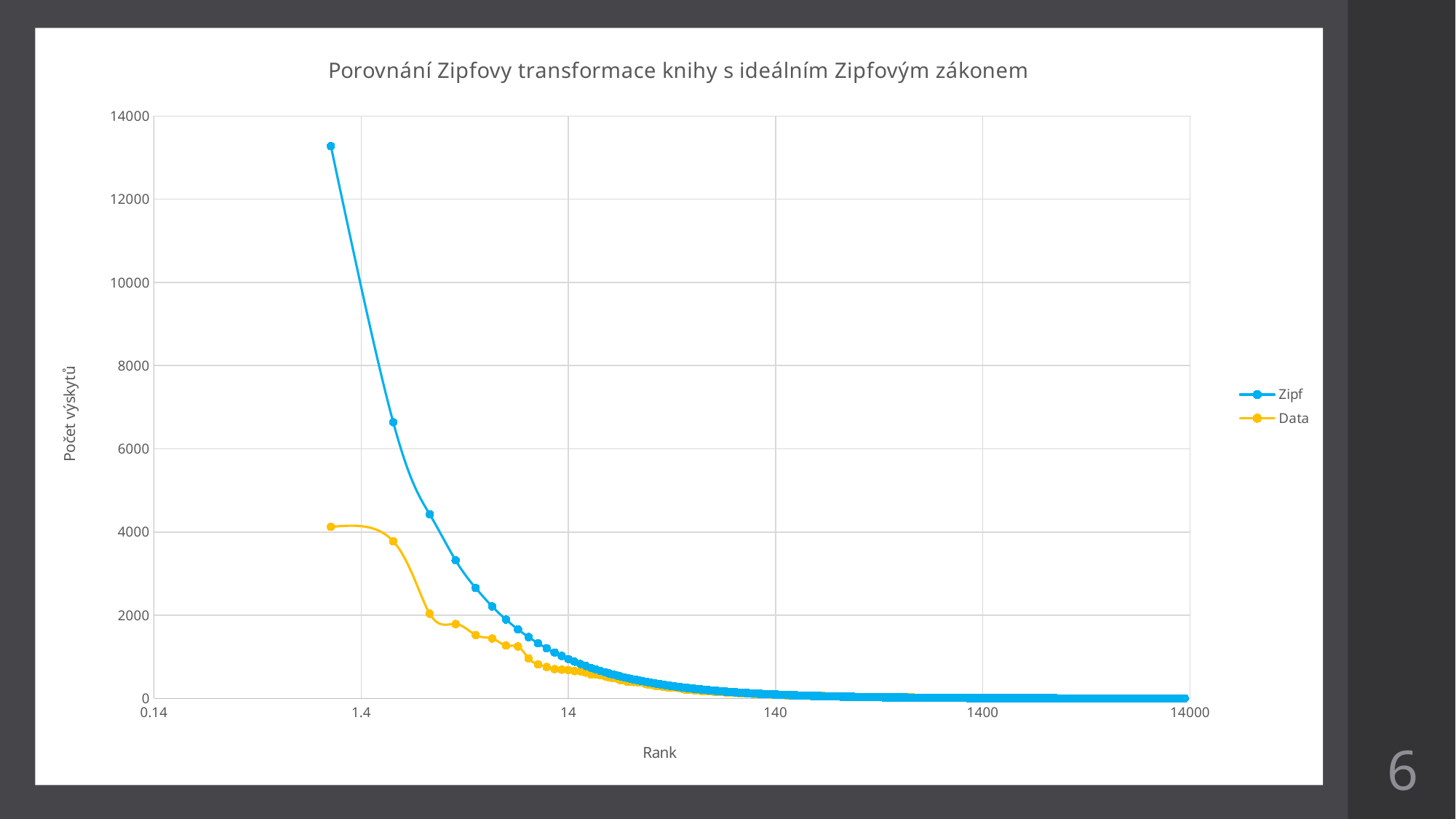
What is the largest value shown on the y axis? 14000 How many series does the legend list? 2 What is the label of the x axis? Rank Do the values of the Zipf series rise or fall as rank increases along the x axis? fall At the lowest rank, which series has the larger value, Zipf or Data? Zipf Which series reaches the highest value on the chart? Zipf Is the highest value of the Data series greater or less than 6000? less Is the highest value of the Data series greater or less than 2000? greater Which series is drawn in blue? Zipf What kind of chart is shown on the slide? line chart What is the title of the chart? Porovnání Zipfovy transformace knihy s ideálním Zipfovým zákonem Is the highest value of the Zipf series greater or less than 12000? greater